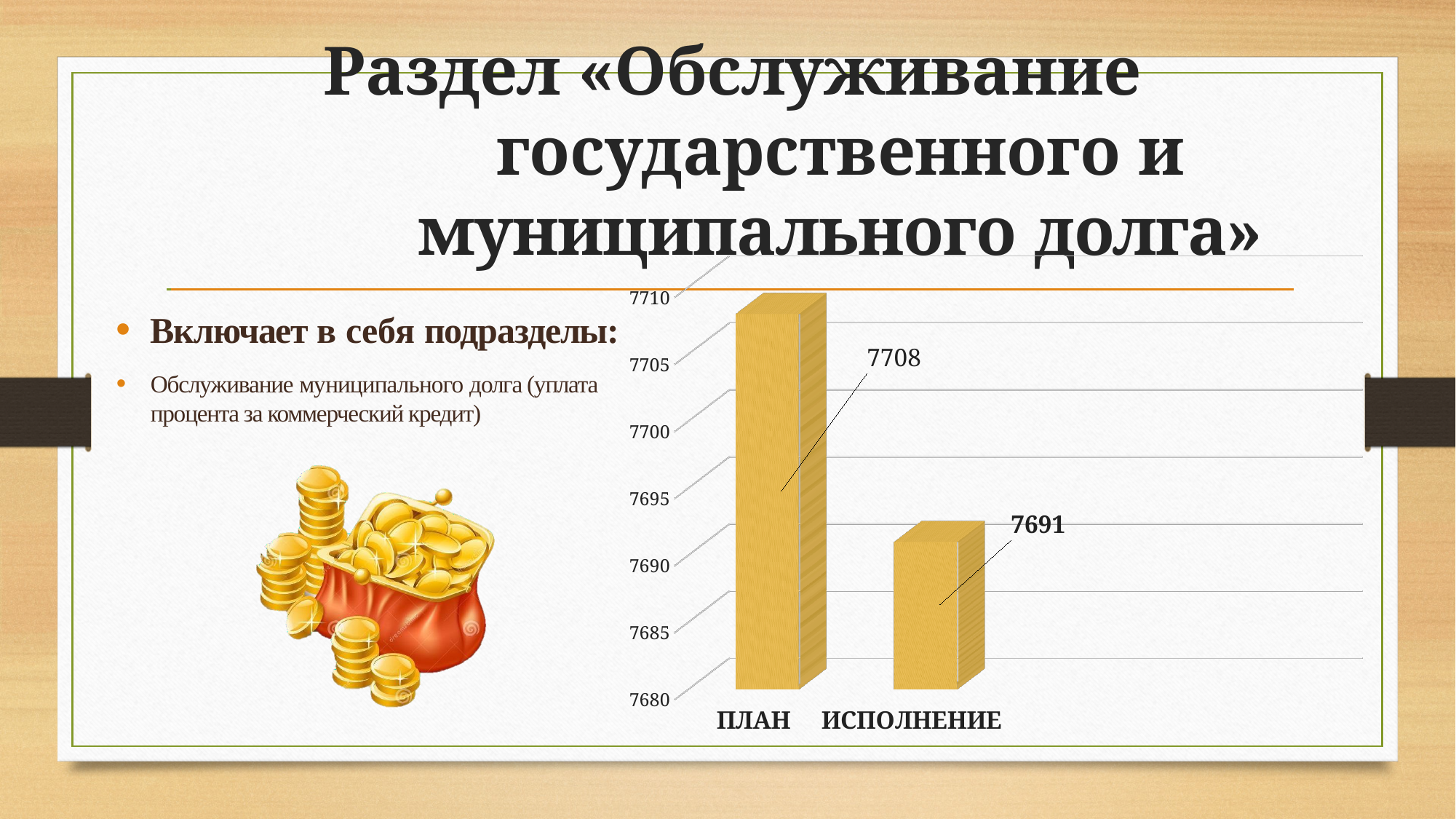
How many categories are shown on the chart? 2 Which is larger, the value for ПЛАН or the value for ИСПОЛНЕНИЕ? ПЛАН What is the difference between the values for ПЛАН and ИСПОЛНЕНИЕ? 17 What is the value for ПЛАН? 7708 What kind of chart is shown on the slide? bar chart Which category has the lowest value? ИСПОЛНЕНИЕ Which category has the highest value? ПЛАН What is the value for ИСПОЛНЕНИЕ? 7691 What is the lowest value shown on the vertical axis of the chart? 7680 Do the values rise or fall from ПЛАН to ИСПОЛНЕНИЕ? fall Is the value for ПЛАН greater or less than 7705? greater Is the value for ИСПОЛНЕНИЕ greater or less than 7700? less